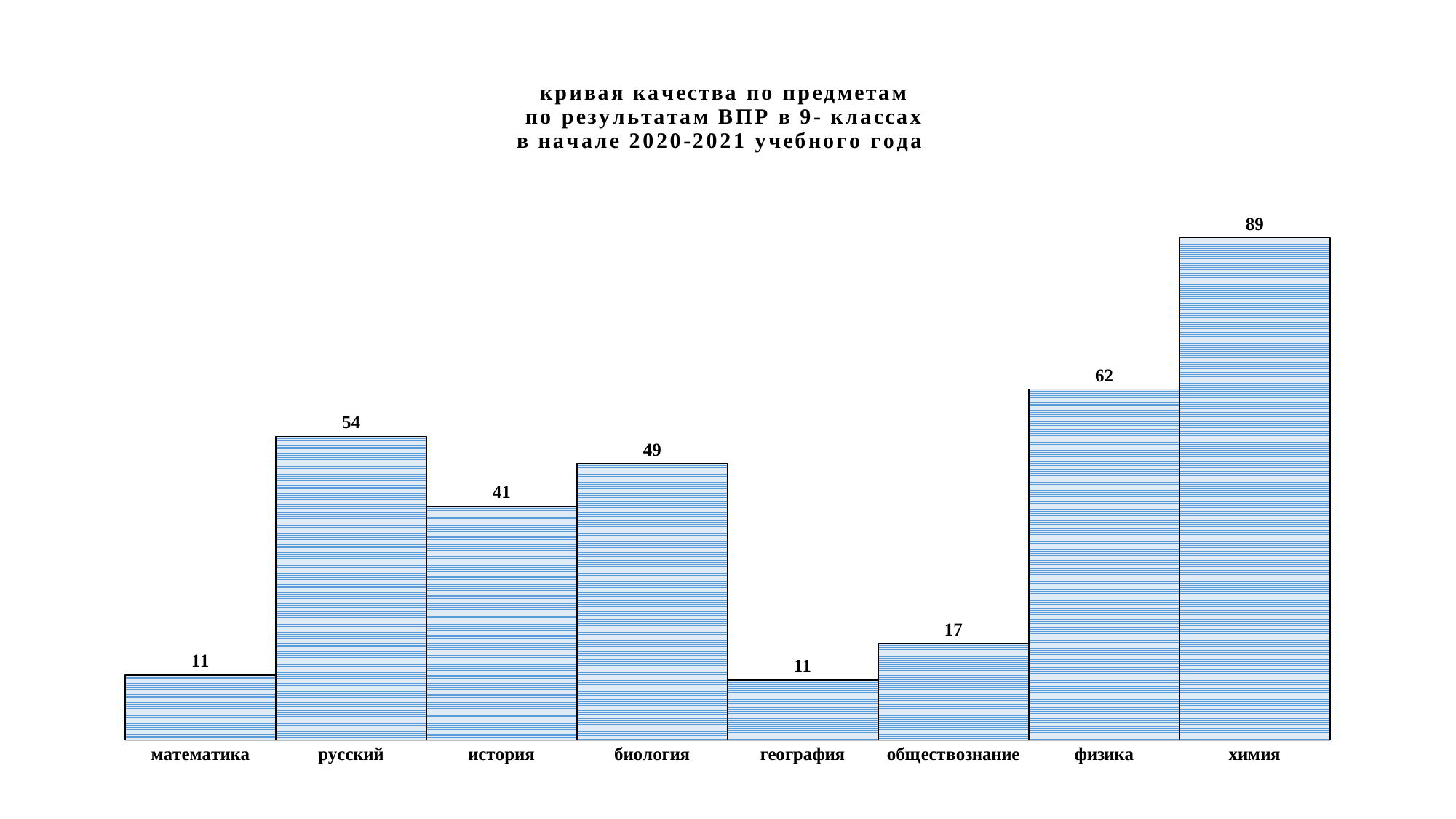
How many subjects are shown on the chart? 8 What is the value for химия? 89 What is the difference between the values for русский and история? 13 Which subjects share the lowest value? математика and география Which school year is named in the chart title? 2020-2021 What is the difference between the values for физика and биология? 13 Which subject has the highest value? химия What is the value for русский? 54 What is the value for физика? 62 What is the value for обществознание? 17 Which is larger, the value for история or the value for биология? биология What kind of chart is shown on the slide? bar chart